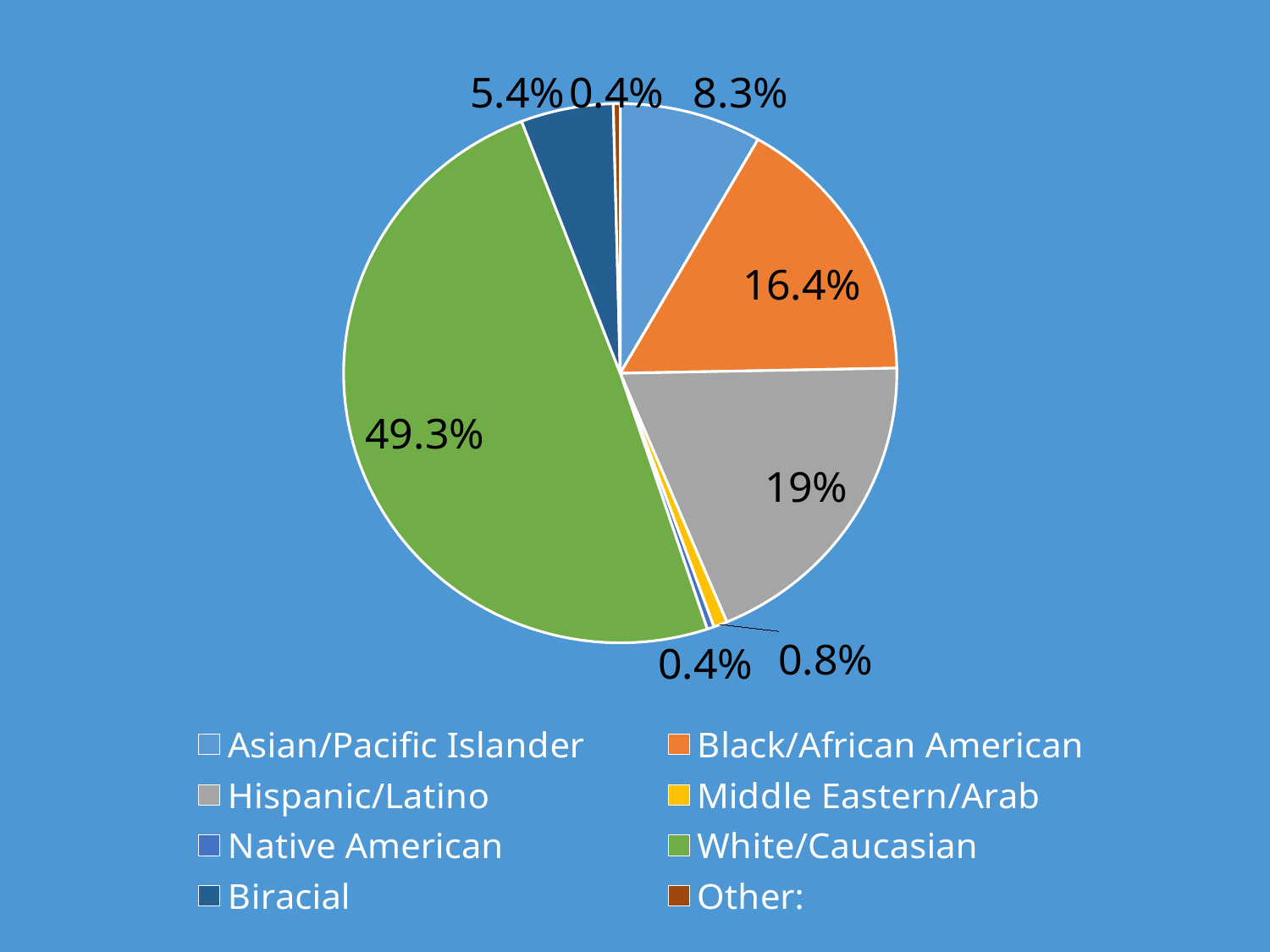
How many categories does the legend list? 8 What percentage of the pie is Black/African American? 16.4% What percentage of the pie is Middle Eastern/Arab? 0.8% What percentage of the pie is Asian/Pacific Islander? 8.3% What colour is the White/Caucasian slice? Green What percentage of the pie is Biracial? 5.4% What percentage of the pie is Hispanic/Latino? 19% Which is larger, the Hispanic/Latino slice or the Black/African American slice? Hispanic/Latino Which category has the largest share of the pie? White/Caucasian What percentage of the pie is White/Caucasian? 49.3% What kind of chart is shown on the slide? Pie chart What is the difference between the White/Caucasian share and the Hispanic/Latino share? 30.3%